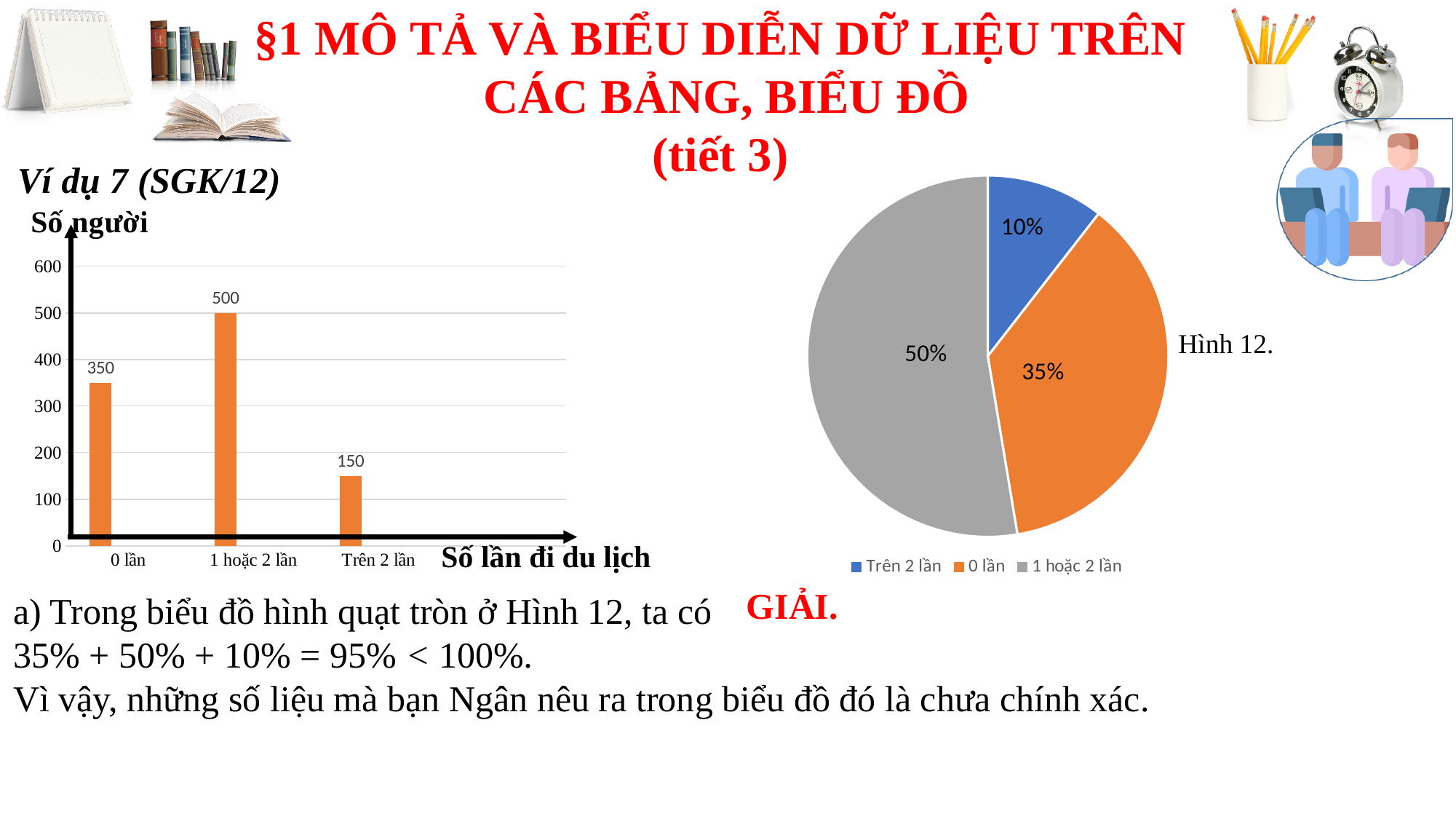
In the pie chart (Hình 12), what share does the 'Trên 2 lần' slice have? 10% In the pie chart (Hình 12), how many entries does the legend list? 3 In the bar chart on the left, what is the value for '0 lần'? 350 In the bar chart on the left, what is the value for '1 hoặc 2 lần'? 500 What kind of chart is the chart on the left of the slide? Bar chart In the pie chart (Hình 12), what share does the '0 lần' slice have? 35% In the bar chart on the left, which category has the highest value? 1 hoặc 2 lần In the bar chart on the left, how many categories are shown on the x axis? 3 In the pie chart (Hình 12), which slice is the largest? 1 hoặc 2 lần In the bar chart on the left, which category has the lowest value? Trên 2 lần In the bar chart on the left, what is the difference between the values for '1 hoặc 2 lần' and 'Trên 2 lần'? 350 In the bar chart on the left, what is the label of the vertical axis? Số người